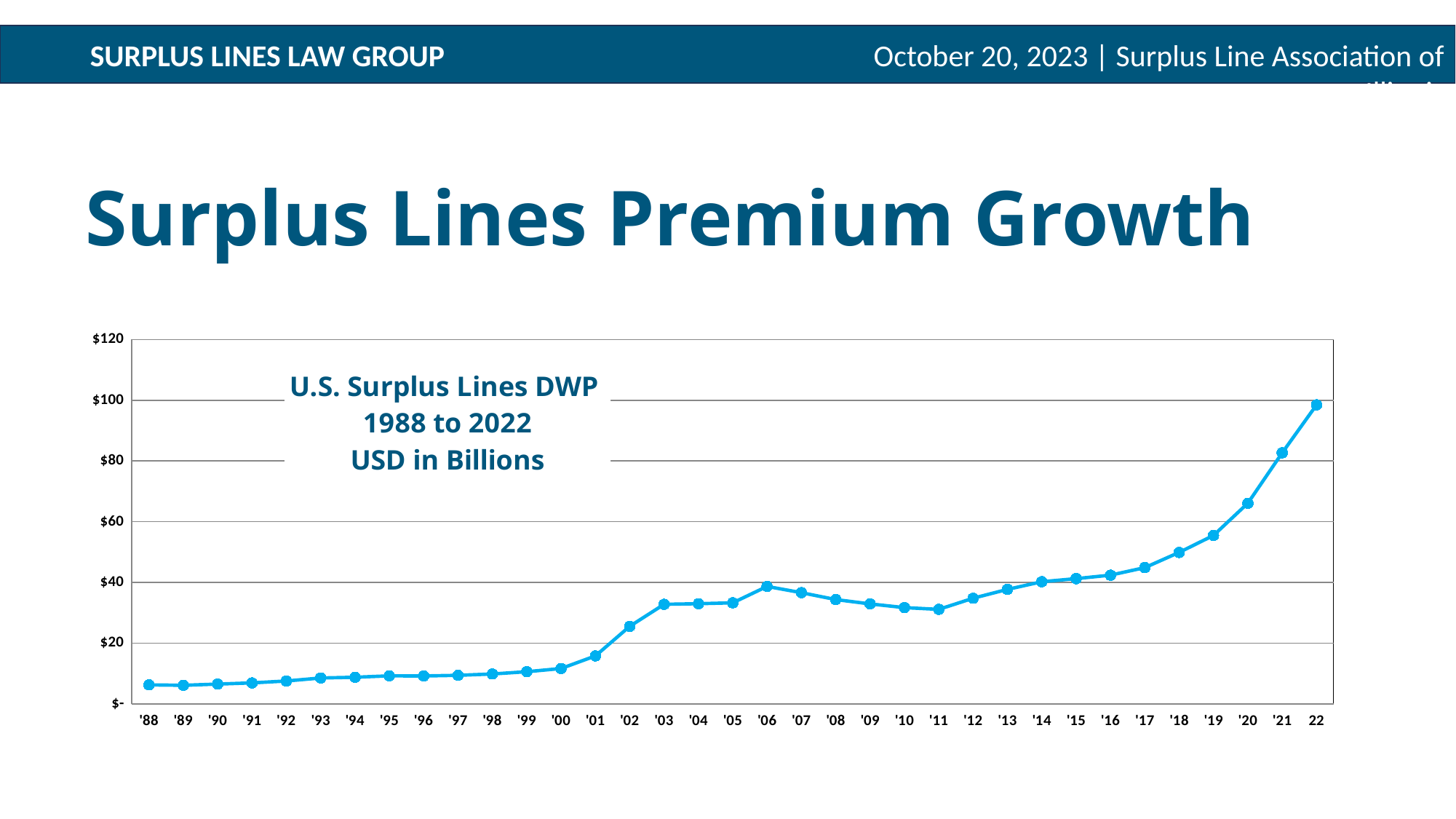
Is the value for '11 greater or less than $40? less How many years (data points) are plotted on the chart? 35 Is the value for '22 greater or less than $80? greater Which is larger, the value for '02 or the value for '19? '19 What is the title shown inside the chart? U.S. Surplus Lines DWP 1988 to 2022 USD in Billions Is the value for '88 greater or less than $20? less Which year has the highest value on the chart? 22 What kind of chart is shown on the slide? line chart Which is larger, the value for '06 or the value for '11? '06 Overall, do the values rise or fall from '88 to '22? rise